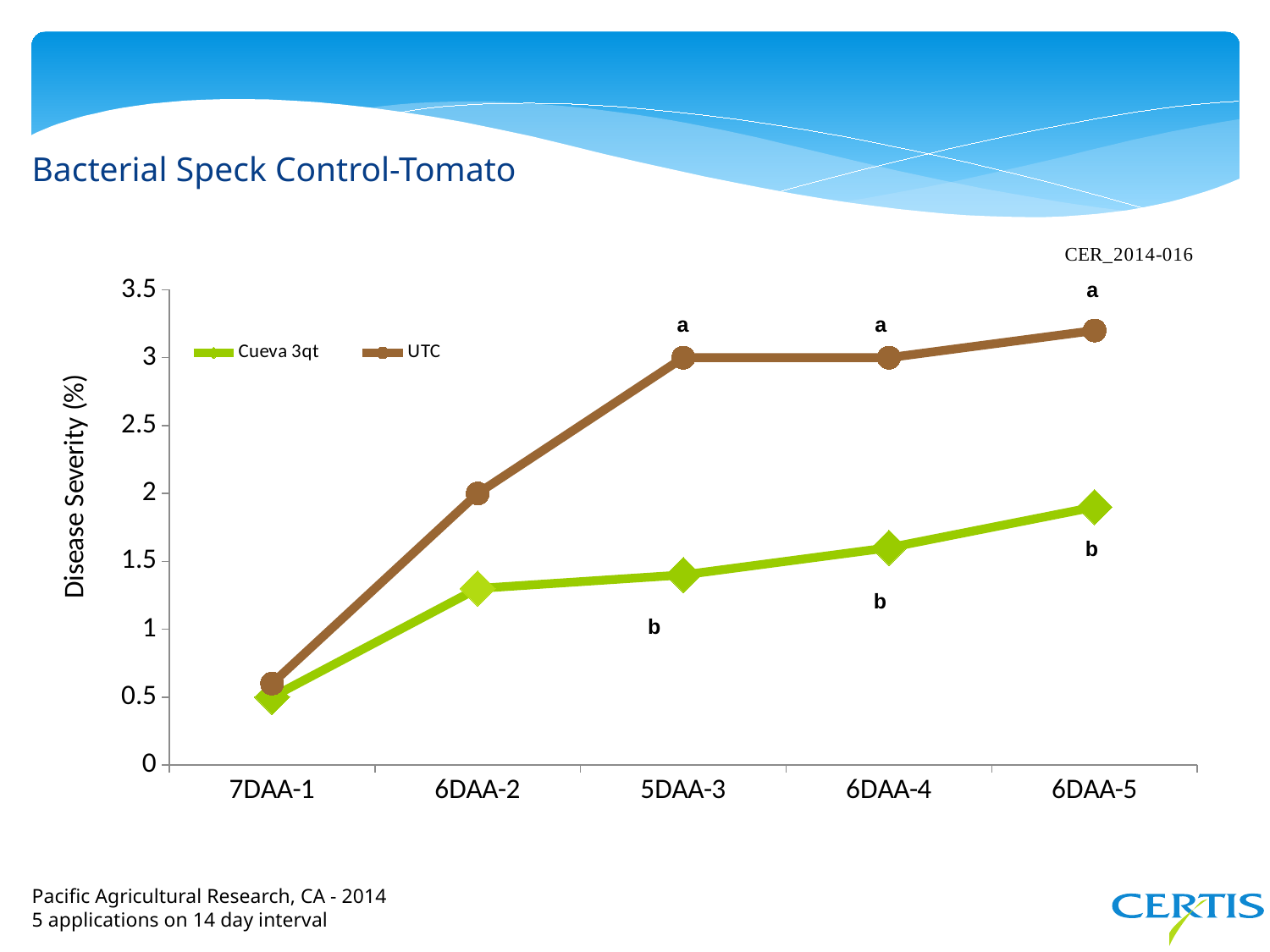
What kind of chart is shown on the slide? line chart What is the UTC value at 5DAA-3? 3 Does the Cueva 3qt series rise or fall from 7DAA-1 to 6DAA-5? rise Is the Cueva 3qt value at 5DAA-3 greater or less than 1.5? less What is the label of the y axis? Disease Severity (%) How many categories are shown on the x axis? 5 Is the Cueva 3qt value at 6DAA-5 greater or less than 2? less At 6DAA-5, which series has the larger value, Cueva 3qt or UTC? UTC How many series does the legend list? 2 Is the UTC value at 6DAA-5 greater or less than 3? greater What is the UTC value at 6DAA-2? 2 At which category does the UTC series reach its highest value? 6DAA-5